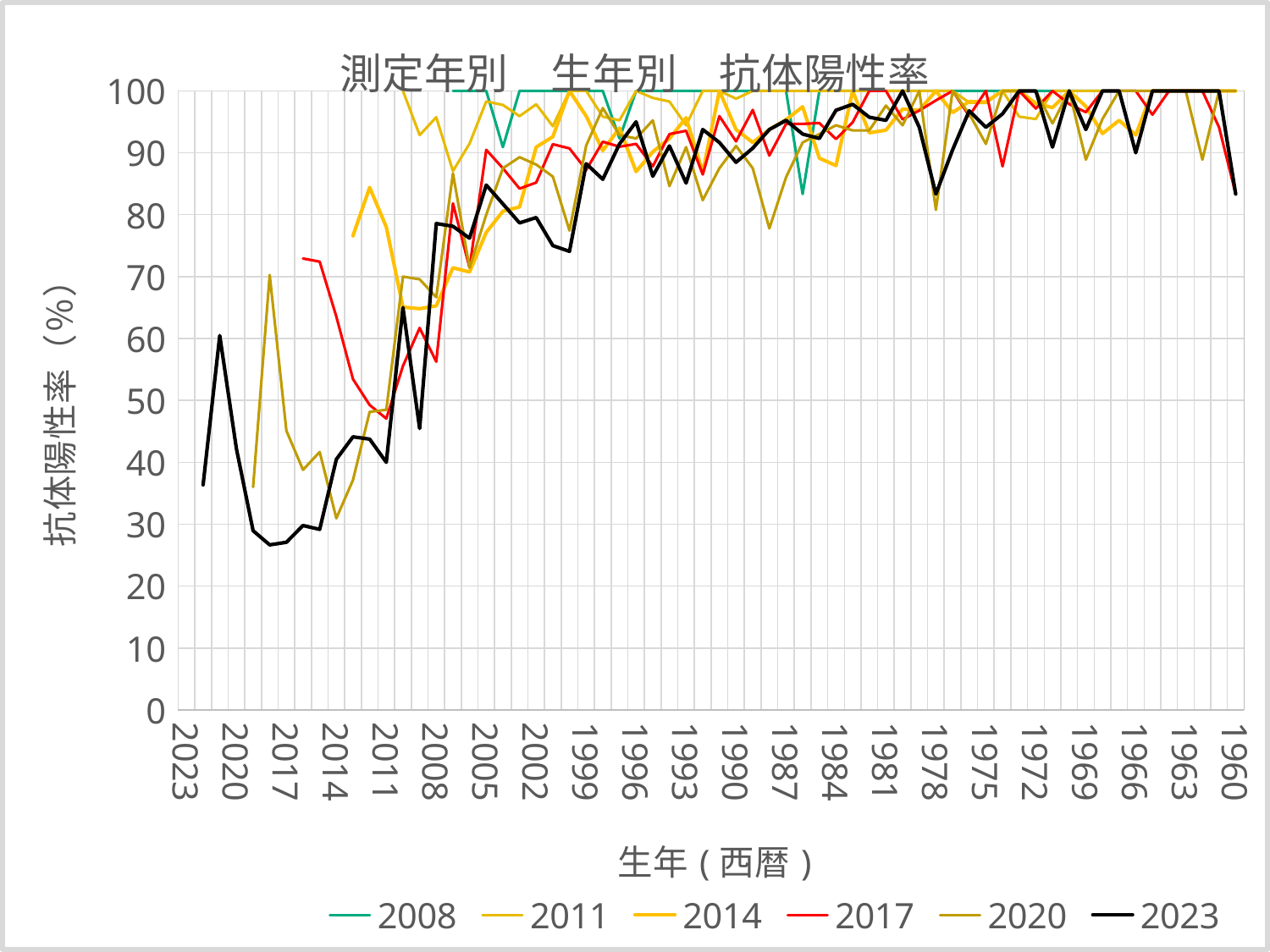
What kind of chart is shown on the slide? line chart Is the value of the 2023 series at birth year 2017 greater or less than 40? less What is the label of the y axis? 抗体陽性率（%） At birth year 2017, which series has the higher value, 2020 or 2023? 2020 Is the value of the 2023 series at birth year 2020 greater or less than 50? less How many series does the legend list? 6 Is the value of the 2017 series at birth year 2016 greater or less than 60? greater What is the title of the chart? 測定年別 生年別 抗体陽性率 Moving along the x axis from birth year 2017 toward 1990, do the values of the 2023 series generally rise or fall? rise Which series reaches the lowest value anywhere on the chart? 2023